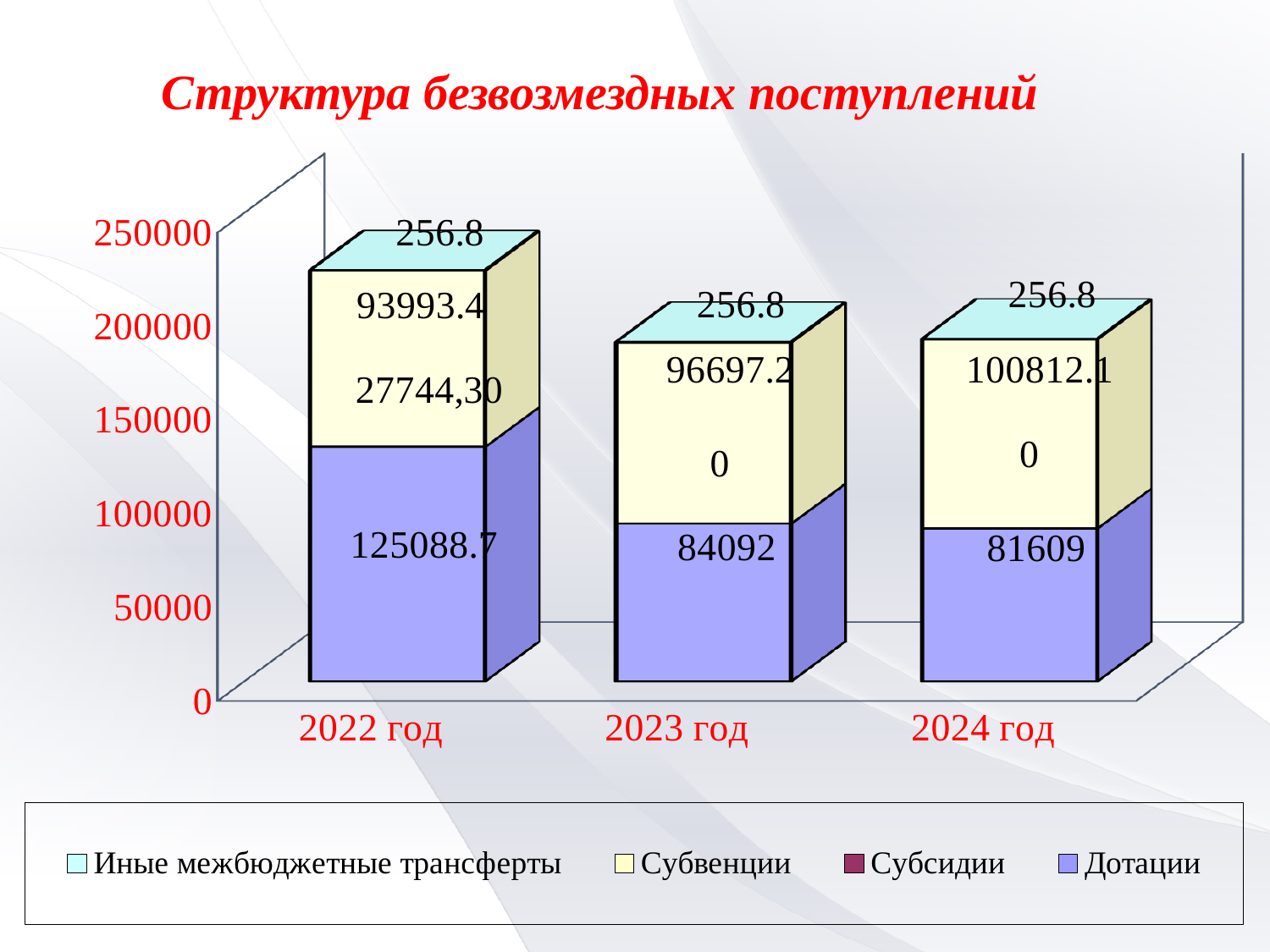
Which year has the larger Субвенции value, 2023 год or 2024 год? 2024 год What is the value of Субсидии for 2023 год? 0 How many series does the legend list? 4 What is the difference between the Дотации values for 2023 год and 2024 год? 2483 Which year has the highest value for Дотации? 2022 год What is the value of Дотации for 2022 год? 125088.7 How many years are shown on the x axis? 3 Which year has the lowest value for Дотации? 2024 год What kind of chart is shown on the slide? Stacked bar chart What is the value of Субвенции for 2024 год? 100812.1 What is the value of Иные межбюджетные трансферты for 2023 год? 256.8 Do the Субвенции values rise or fall from 2022 год to 2024 год? Rise